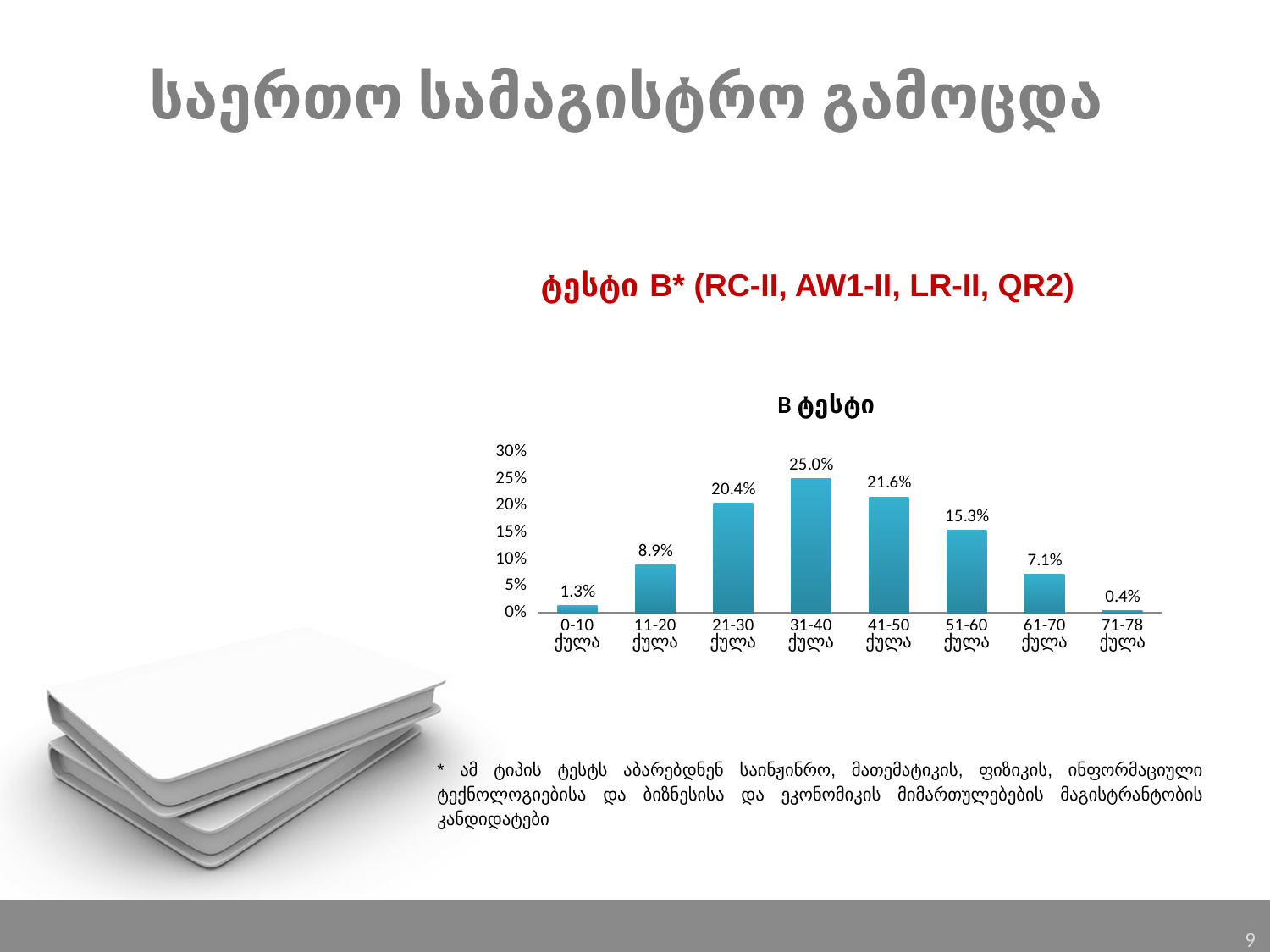
What is the difference between the values for 31-40 ქულა and 41-50 ქულა? 3.4% Is the value for 51-60 ქულა greater or less than 20%? less Which is larger, the value for 21-30 ქულა or the value for 41-50 ქულა? 41-50 ქულა What is the difference between the values for 21-30 ქულა and 51-60 ქულა? 5.1% Which category has the lowest value? 71-78 ქულა What is the value for the 11-20 ქულა category? 8.9% Which category has the highest value? 31-40 ქულა What is the value for the 31-40 ქულა category? 25.0% How many categories are shown on the x axis? 8 What kind of chart is shown on the slide? bar chart What is the title of the chart? B ტესტი What is the value for the 61-70 ქულა category? 7.1%